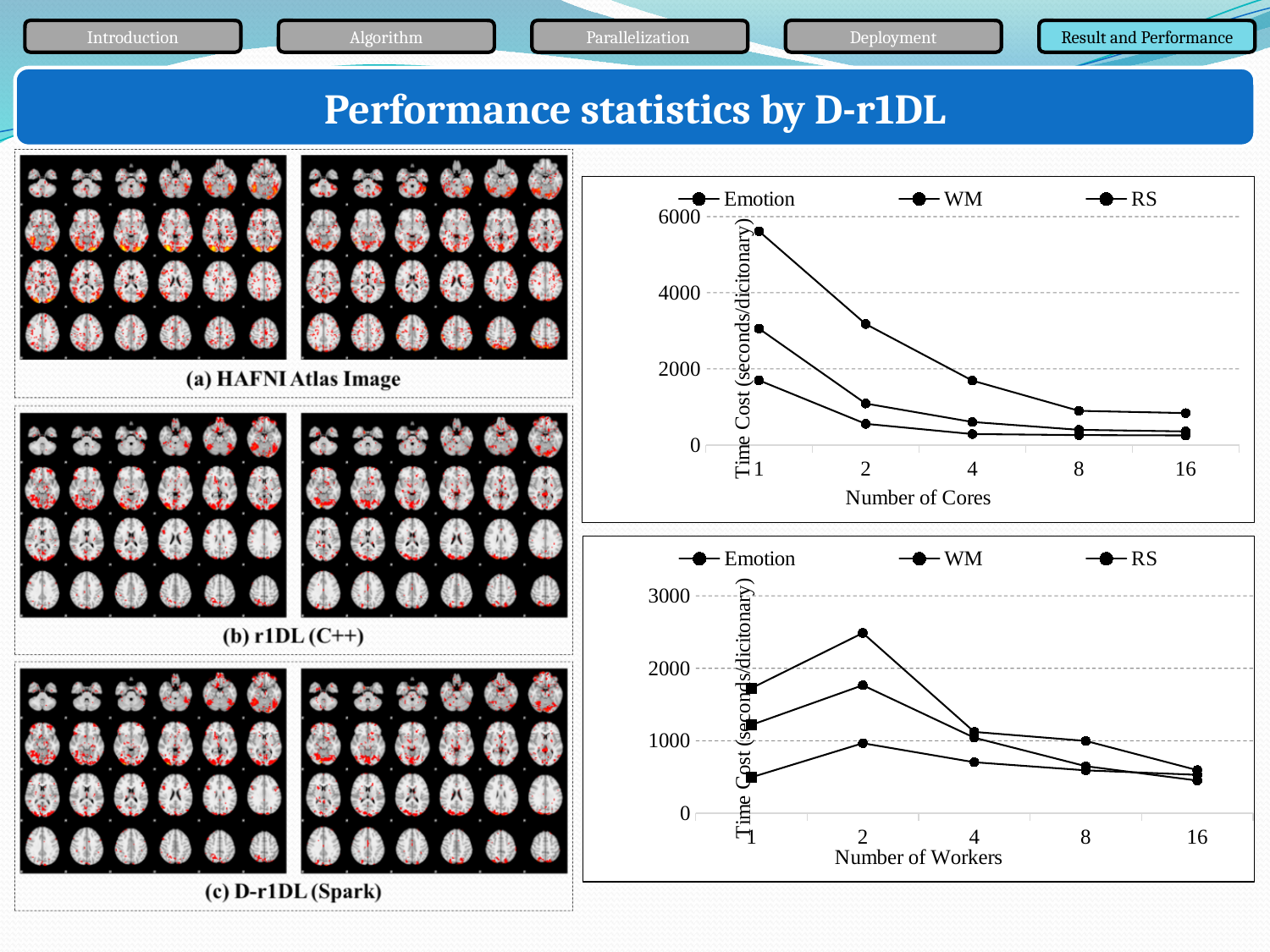
In the top chart (Number of Cores), do the values rise or fall as the number of cores increases? fall What is the x-axis title of the bottom chart? Number of Workers What kind of chart is the top chart (Number of Cores)? line chart How many points along the x axis does the top chart (Number of Cores) plot for each series? 5 How many series does the legend of the bottom chart (Number of Workers) list? 3 How many series does the legend of the top chart (Number of Cores) list? 3 In the bottom chart (Number of Workers), is the highest value at 2 workers greater or less than 2000? greater In the top chart (Number of Cores), is the highest value at 1 core greater or less than 4000? greater In the top chart (Number of Cores), are all values at 16 cores greater or less than 2000? less What kind of chart is the bottom chart (Number of Workers)? line chart How many points along the x axis does the bottom chart (Number of Workers) plot for each series? 5